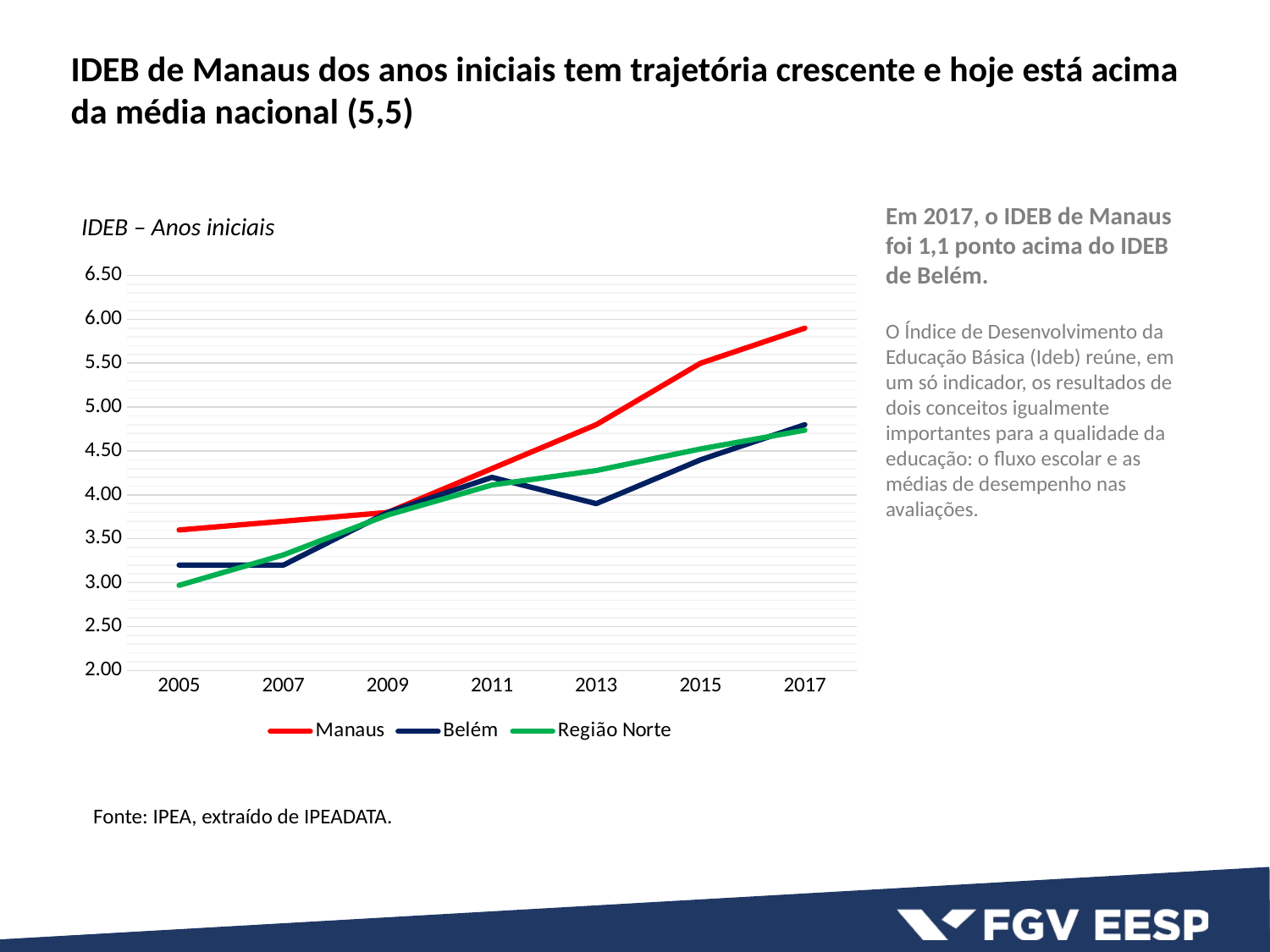
Does the Manaus line rise or fall from 2005 to 2017? rises What is the title of the chart? IDEB – Anos iniciais Which series has the lowest value in 2005? Região Norte Is the value for Manaus in 2017 greater or less than 5.50? greater How many series does the chart legend list? 3 Which series has the lowest value in 2013? Belém Which series has the highest value in 2017? Manaus Is the value for Belém in 2013 greater or less than 4.00? less Is the value for Manaus in 2013 greater or less than 4.50? greater How many years are plotted along the x axis of the chart? 7 What kind of chart is shown on the slide? line chart